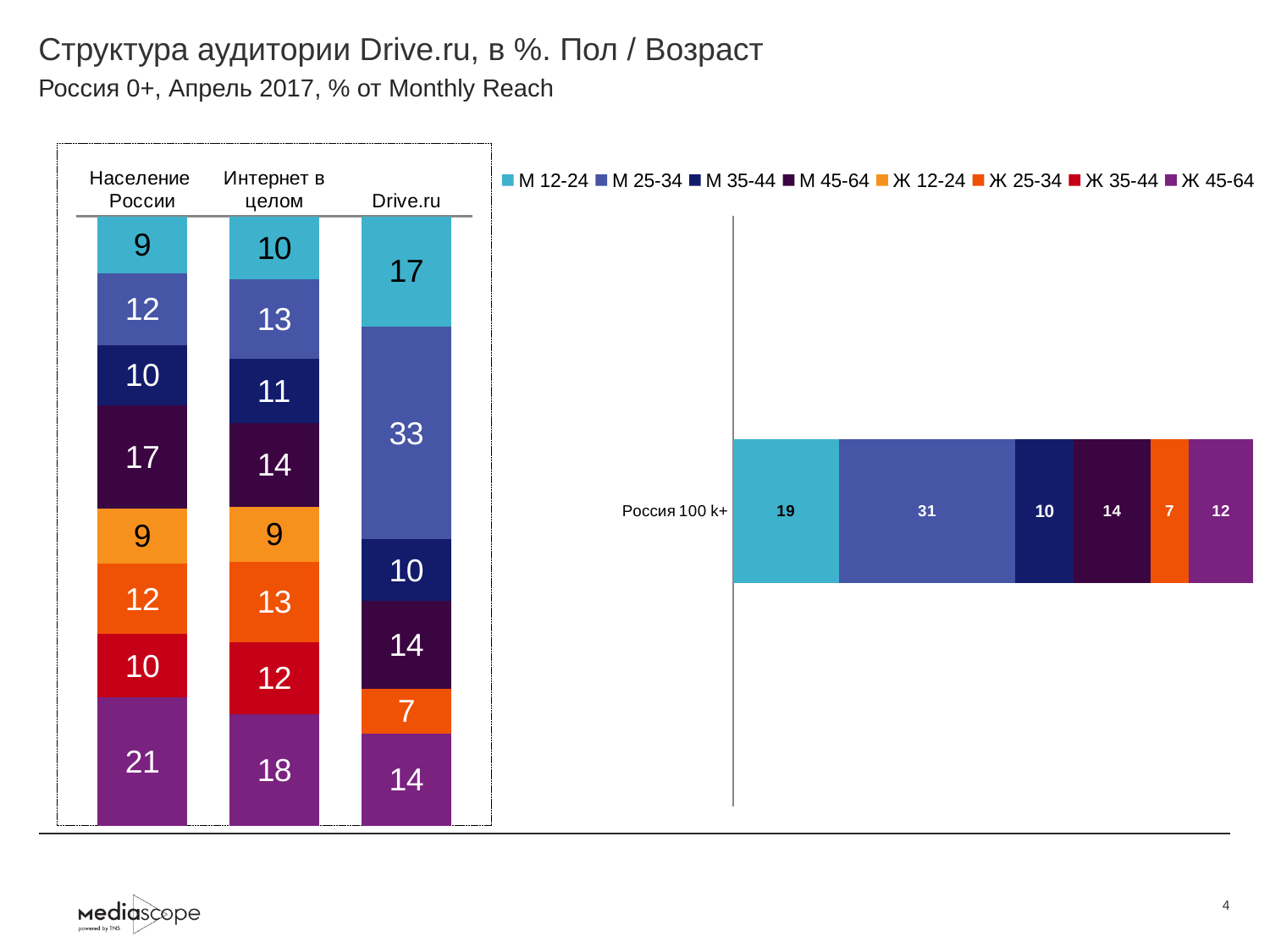
In the right chart (Россия 100 k+), what is the value of the Ж 25-34 segment? 7 In the left chart, which segment of the Население России bar has the largest value? Ж 45-64 In the left chart, what is the difference between the М 25-34 value for Drive.ru and for Интернет в целом? 20 In the left chart, which is larger: the М 12-24 value for Drive.ru or for Население России? Drive.ru How many series does the legend list? 8 What type of chart is the right chart (Россия 100 k+)? Stacked bar chart In the left chart, what is the value of the М 45-64 segment for Интернет в целом? 14 How many bars are in the left chart? 3 In the right chart (Россия 100 k+), what is the value of the М 12-24 segment? 19 In the left chart, what is the value of the Ж 45-64 segment for Население России? 21 In the left chart, what is the value of the М 25-34 segment for Drive.ru? 33 In the left chart, which segment of the Drive.ru bar has the largest value? М 25-34